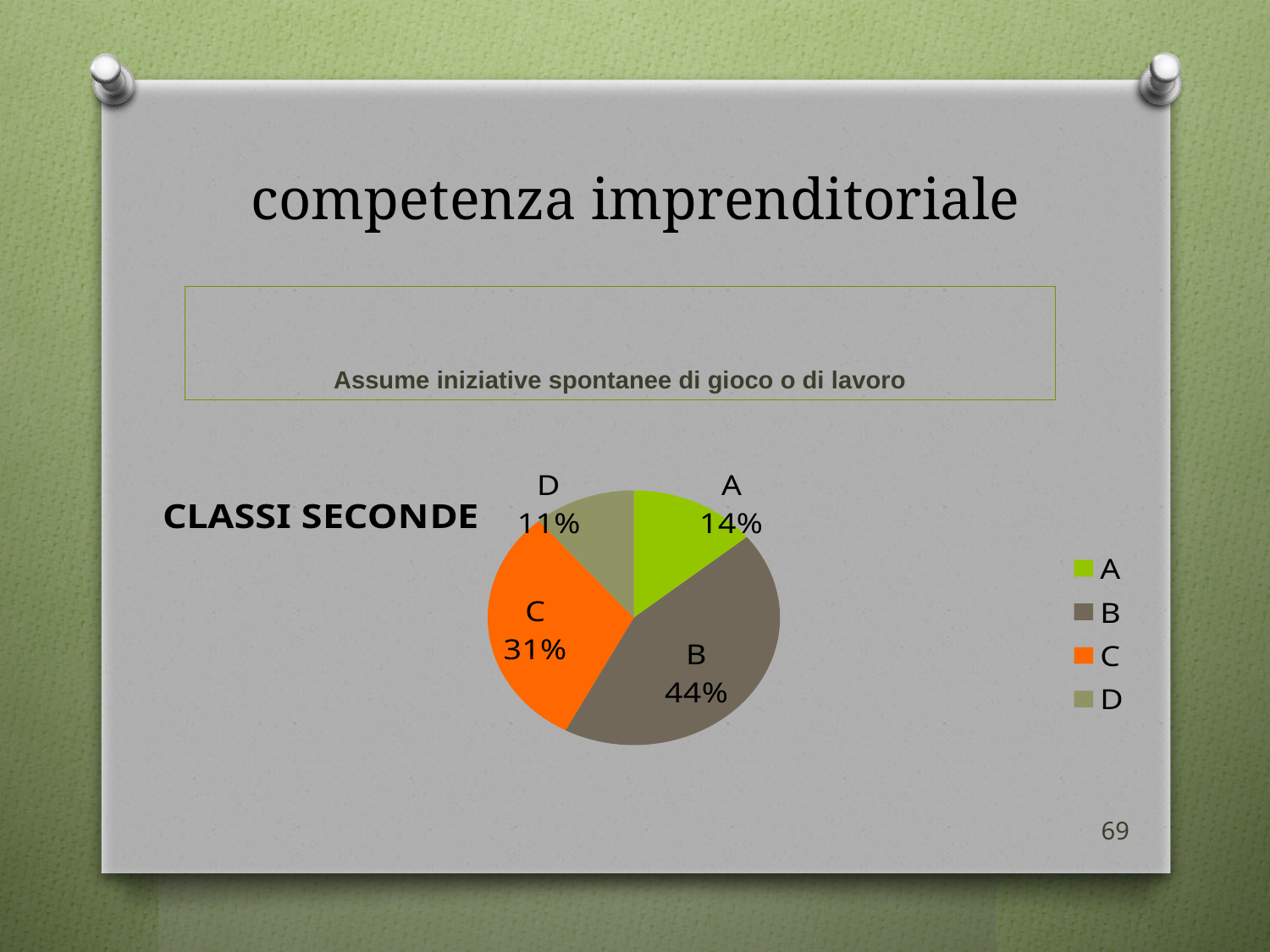
Which is larger, slice A or slice D? A What percentage does slice B represent in the pie chart? 44% What percentage does slice A represent in the pie chart? 14% What percentage does slice C represent in the pie chart? 31% How many entries does the legend list? 4 What is the difference in percentage points between slice B and slice C? 13 What kind of chart is shown on the slide? pie chart What percentage does slice D represent in the pie chart? 11% What colour is slice C in the pie chart? orange How many slices does the pie chart have? 4 Which category has the largest slice in the pie chart? B Which category has the smallest slice in the pie chart? D